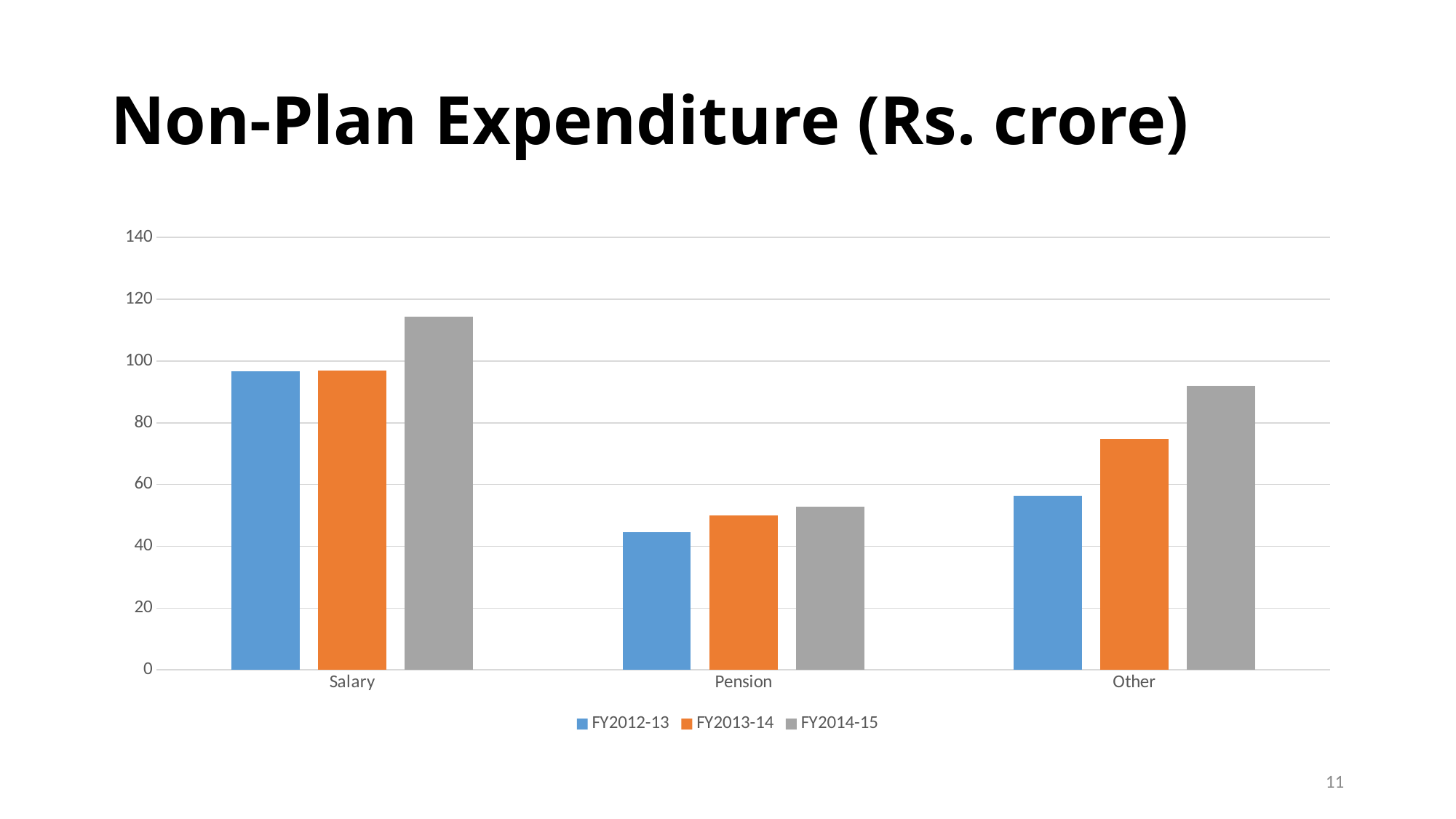
Is the FY2014-15 value for Other greater or less than 80? greater Which category has the lowest FY2012-13 value? Pension Is the FY2013-14 value for Other greater or less than 60? greater Which is larger for Other: the FY2012-13 value or the FY2014-15 value? FY2014-15 Is the FY2014-15 value for Salary greater or less than 100? greater How many series does the legend list? 3 Do the values for Other rise or fall from FY2012-13 to FY2014-15? rise How many categories are shown on the x axis? 3 What is the title of the chart? Non-Plan Expenditure (Rs. crore) What kind of chart is shown on the slide? bar chart Which category has the highest FY2014-15 value? Salary